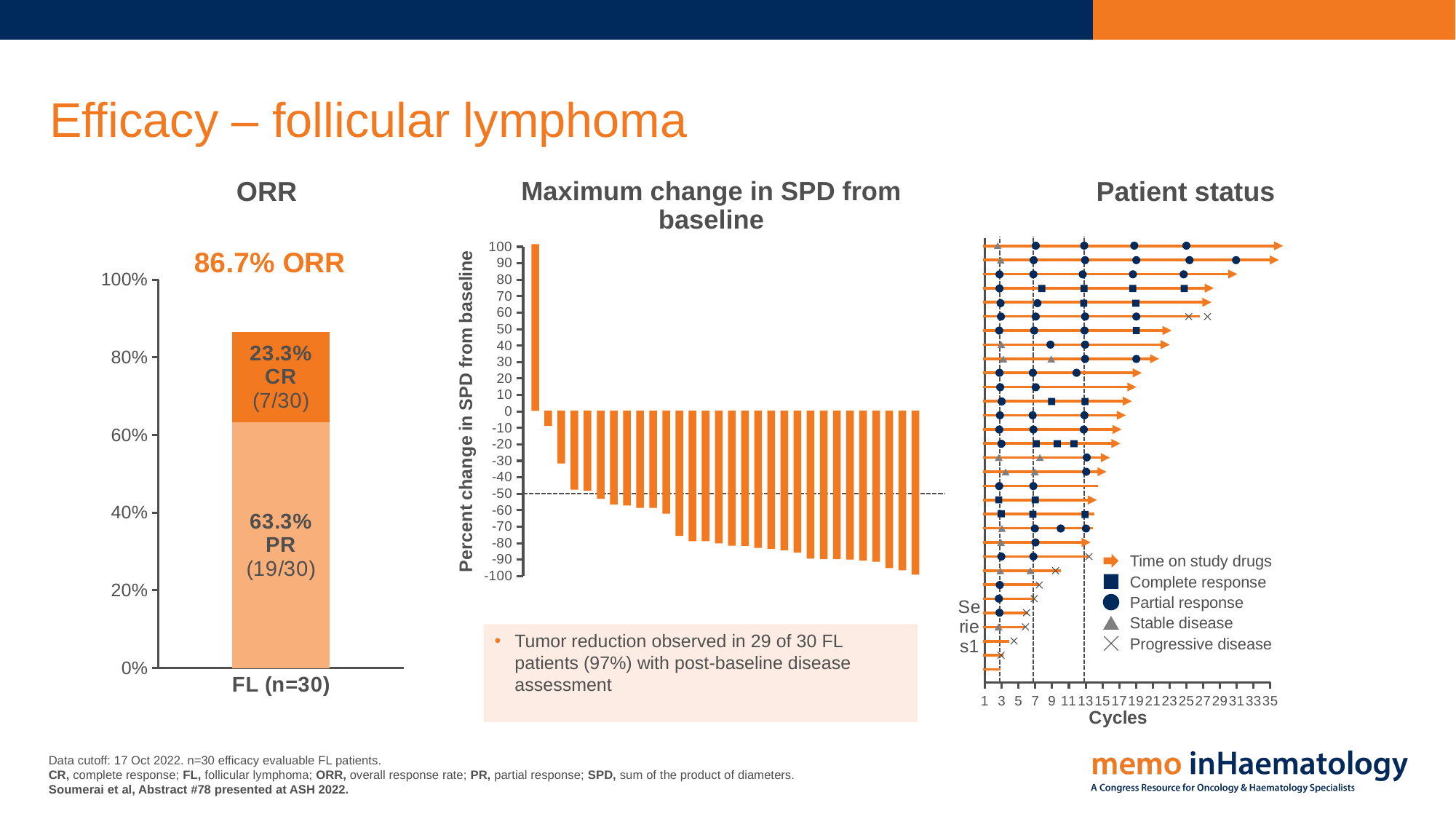
On the 'Patient status' chart, what is the label of the x axis? Cycles On the ORR chart, what is the difference in percentage points between the PR and CR segments? 40 percentage points On the ORR chart, what is the total overall response rate shown for the stacked bar? 86.7% On the 'Maximum change in SPD from baseline' chart, do the bar values rise or fall from left to right? Fall On the ORR chart, what percentage of patients achieved a partial response (PR)? 63.3% On the ORR chart, which segment is larger, CR or PR? PR On the ORR chart, what percentage of patients achieved a complete response (CR)? 23.3% On the 'Maximum change in SPD from baseline' chart, is the value of the first (leftmost) bar greater or less than 50? greater On the 'Patient status' chart, how many entries does the legend list? 5 On the 'Maximum change in SPD from baseline' chart, at what value is the horizontal dashed reference line drawn? -50 On the ORR chart, how many patients out of 30 had a partial response? 19/30 What kind of chart is the ORR chart? Stacked bar chart